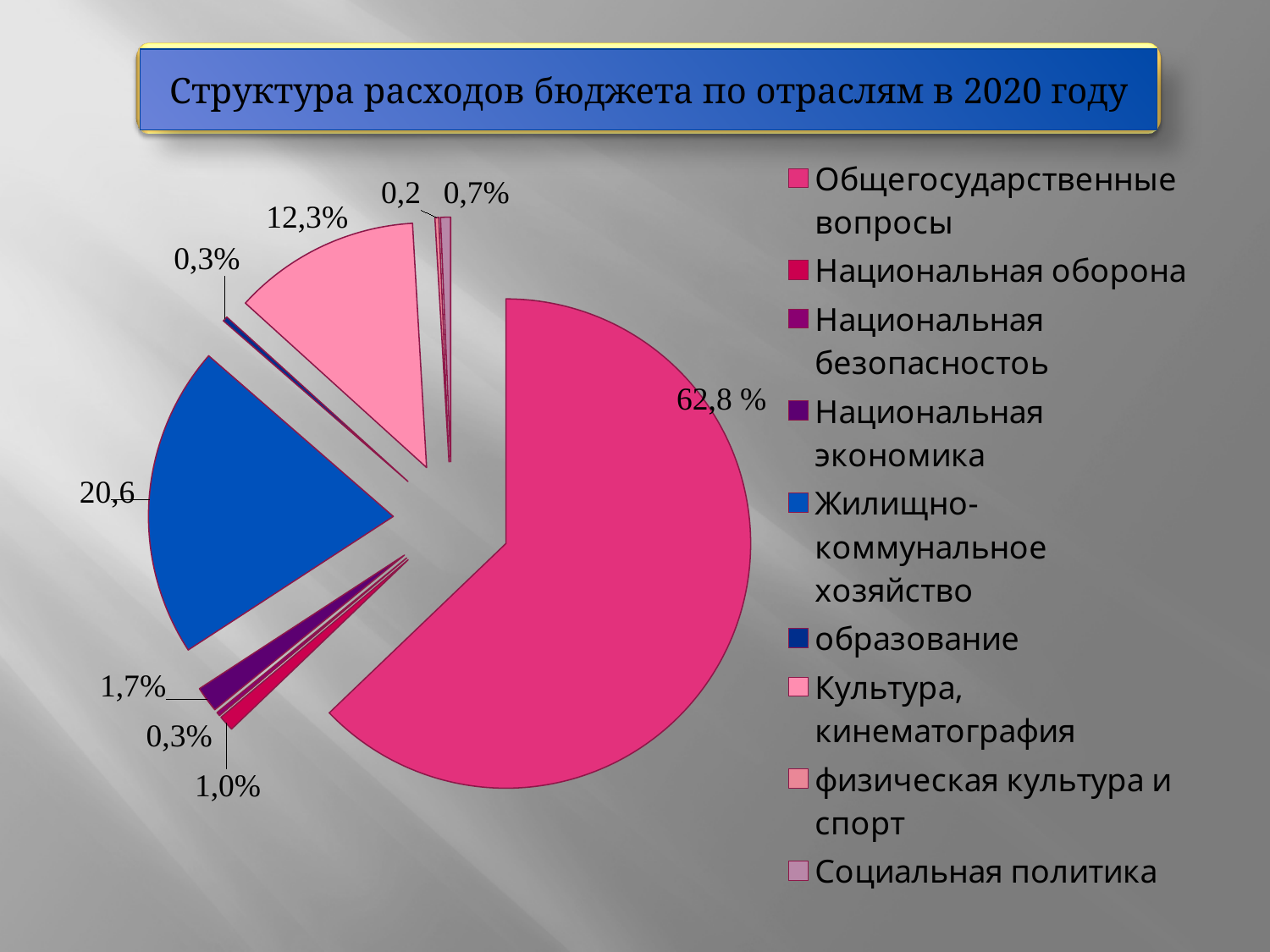
What share is labelled for Культура, кинематография? 12,3% Which is larger: the slice for Жилищно-коммунальное хозяйство or the slice for Культура, кинематография? Жилищно-коммунальное хозяйство What kind of chart is shown on the slide? pie chart What is the difference between the labelled values for Общегосударственные вопросы and Жилищно-коммунальное хозяйство? 42,2 How many categories does the legend list? 9 What share is labelled for Социальная политика? 0,7% What value is labelled for Жилищно-коммунальное хозяйство? 20,6 What share is labelled for Национальная экономика? 1,7% What is the title of the chart? Структура расходов бюджета по отраслям в 2020 году Which category has the largest slice of the pie? Общегосударственные вопросы What share of the pie is labelled for Общегосударственные вопросы? 62,8 % Which category has the smallest slice of the pie? физическая культура и спорт